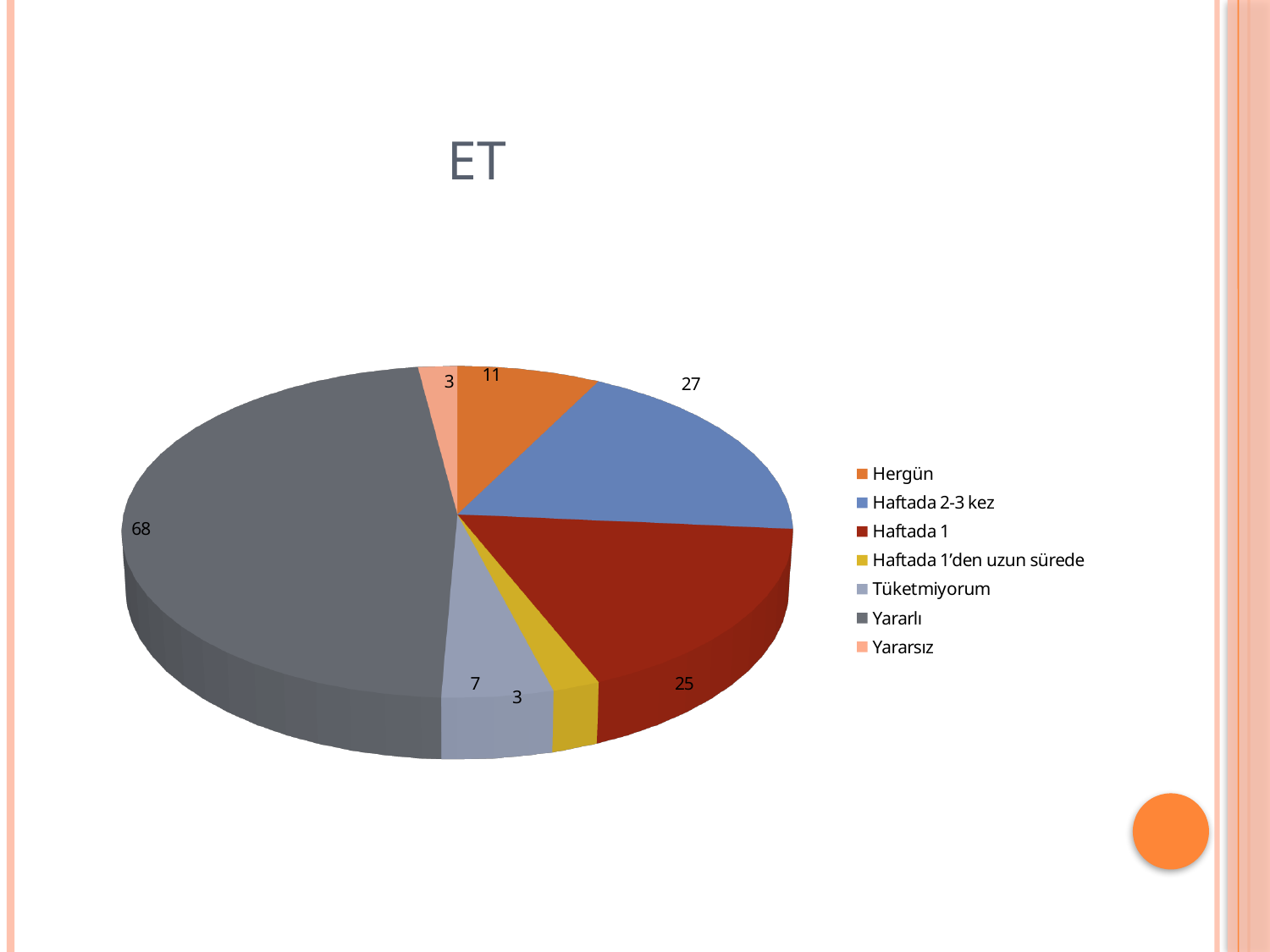
Which category has the largest slice? Yararlı What is the value for Haftada 2-3 kez? 27 What is the value for Haftada 1? 25 What is the difference between the values for Haftada 2-3 kez and Haftada 1? 2 What is the value for Tüketmiyorum? 7 What is the title of the chart? ET What is the value for Hergün? 11 What is the value for Yararlı? 68 What type of chart is shown on the slide? Pie chart Which is larger, the value for Hergün or the value for Tüketmiyorum? Hergün How many entries does the legend list? 7 What is the difference between the values for Yararlı and Haftada 2-3 kez? 41